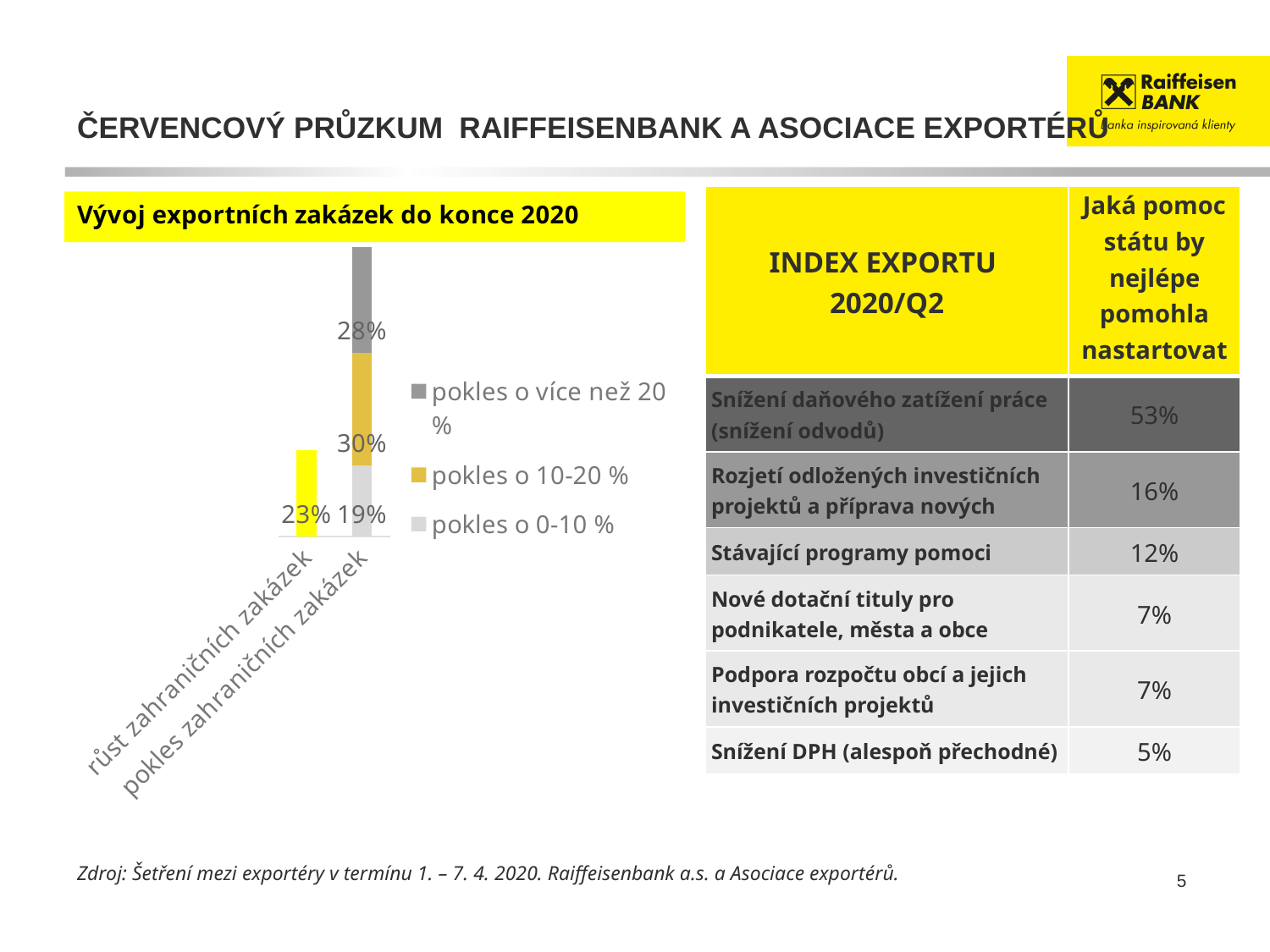
In the chart 'Vývoj exportních zakázek do konce 2020', which segment of the 'pokles zahraničních zakázek' bar is the largest? pokles o 10-20 % What type of chart is shown under the title 'Vývoj exportních zakázek do konce 2020'? bar chart In the chart 'Vývoj exportních zakázek do konce 2020', what is the total of the stacked 'pokles zahraničních zakázek' bar? 77% How many entries does the legend of the chart 'Vývoj exportních zakázek do konce 2020' list? 3 In the chart 'Vývoj exportních zakázek do konce 2020', what is the value of the 'pokles o 10-20 %' segment? 30% In the chart 'Vývoj exportních zakázek do konce 2020', what is the value of the 'pokles o 0-10 %' segment for 'pokles zahraničních zakázek'? 19% How many categories are shown on the x axis of the chart 'Vývoj exportních zakázek do konce 2020'? 2 In the chart 'Vývoj exportních zakázek do konce 2020', which is larger: the 'růst zahraničních zakázek' value or the 'pokles o více než 20 %' segment? pokles o více než 20 % In the chart 'Vývoj exportních zakázek do konce 2020', which segment of the 'pokles zahraničních zakázek' bar is the smallest? pokles o 0-10 % In the chart 'Vývoj exportních zakázek do konce 2020', what is the value of the 'pokles o více než 20 %' segment? 28% In the chart 'Vývoj exportních zakázek do konce 2020', what is the difference between the 'pokles o 10-20 %' segment and the 'pokles o 0-10 %' segment? 11% In the chart 'Vývoj exportních zakázek do konce 2020', what is the value labelled for 'růst zahraničních zakázek'? 23%